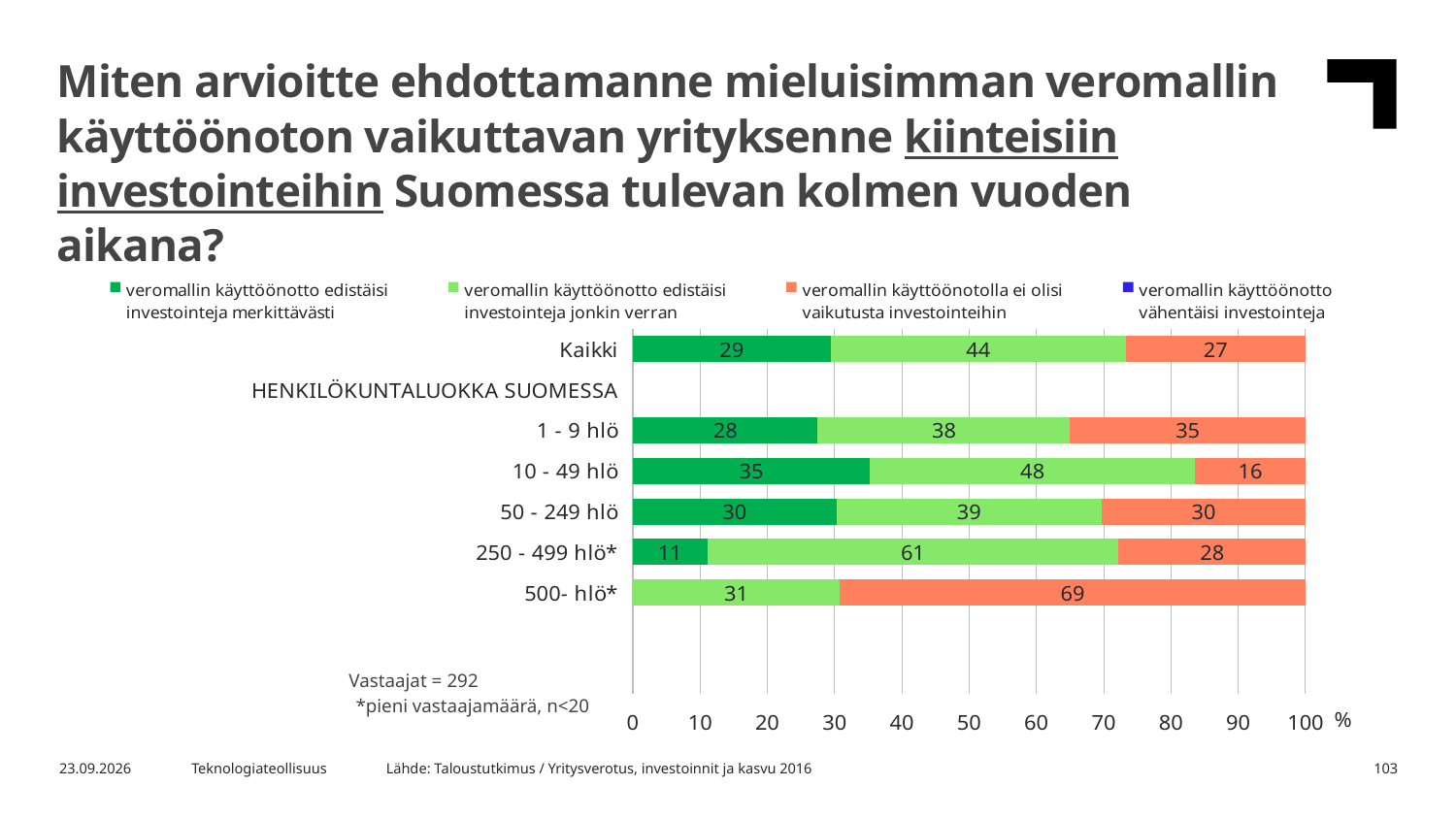
What is the value of 'veromallin käyttöönotto edistäisi investointeja merkittävästi' for Kaikki? 29 What is the total of the stacked bar for 1 - 9 hlö? 101 Which category has the highest value for 'veromallin käyttöönotolla ei olisi vaikutusta investointeihin'? 500- hlö* How many series does the legend list? 4 Which category has the lowest value for 'veromallin käyttöönotolla ei olisi vaikutusta investointeihin'? 10 - 49 hlö Which is larger for 50 - 249 hlö: 'veromallin käyttöönotto edistäisi investointeja merkittävästi' or 'veromallin käyttöönotto edistäisi investointeja jonkin verran'? veromallin käyttöönotto edistäisi investointeja jonkin verran What is the difference between the 'veromallin käyttöönotto edistäisi investointeja jonkin verran' values for 10 - 49 hlö and 1 - 9 hlö? 10 What is the value of 'veromallin käyttöönotto edistäisi investointeja jonkin verran' for 250 - 499 hlö*? 61 How many respondents (Vastaajat) are stated on the slide? 292 Which category has the highest value for 'veromallin käyttöönotto edistäisi investointeja merkittävästi'? 10 - 49 hlö What kind of chart is shown on the slide? stacked bar chart What is the value of 'veromallin käyttöönotolla ei olisi vaikutusta investointeihin' for 500- hlö*? 69